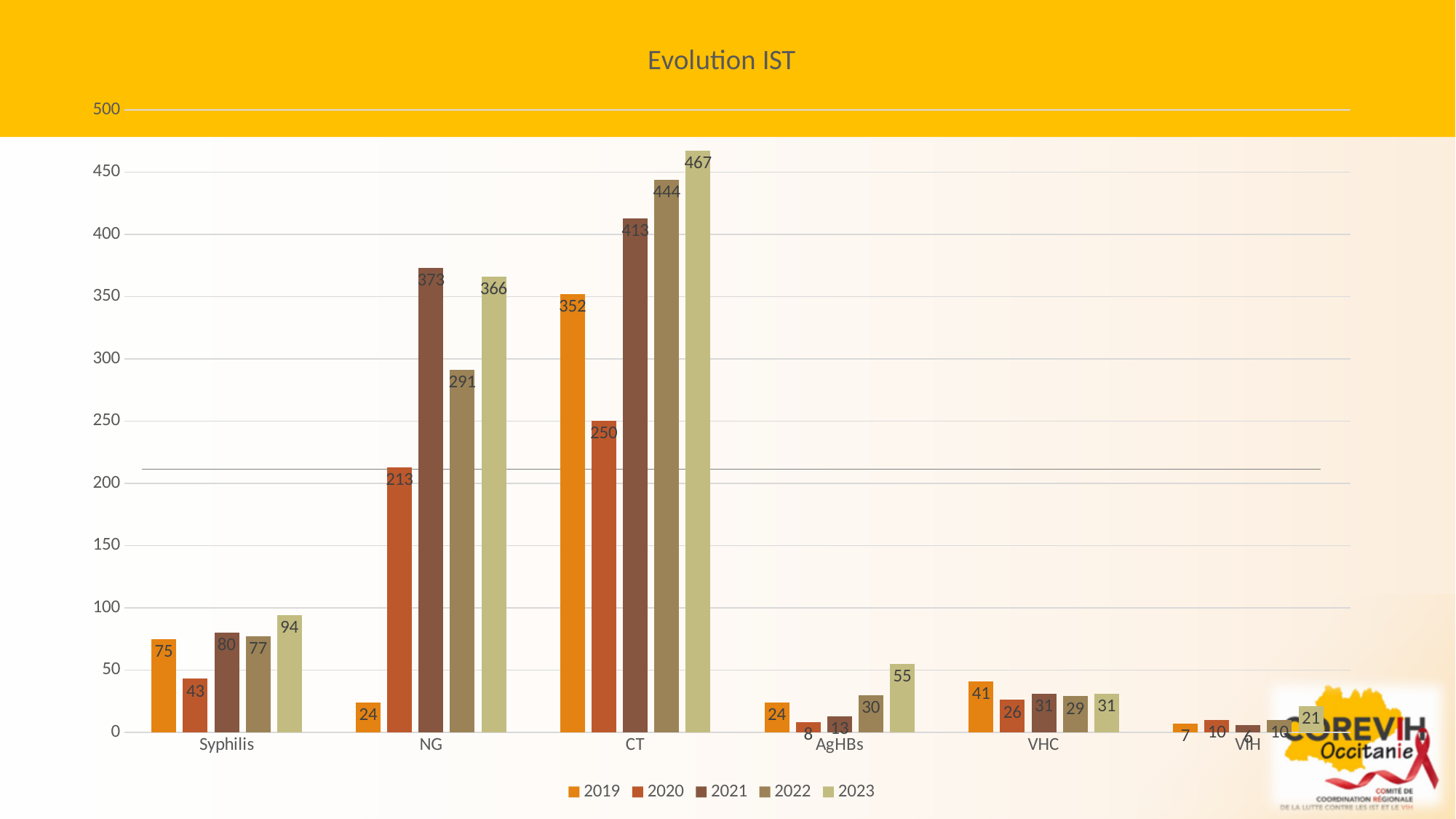
What is the title of the chart? Evolution IST What is the value for AgHBs in 2020? 8 What kind of chart is shown on the slide? Bar chart What is the value for CT in 2023? 467 How many series does the legend list? 5 How many categories are shown on the x axis? 6 What is the value for Syphilis in 2023? 94 Which year has the lowest value for VIH? 2021 What is the value for NG in 2020? 213 Which year has the highest value for NG? 2021 Which is larger, the 2022 value for NG or the 2023 value for NG? 2023 What is the difference between the CT values for 2023 and 2019? 115